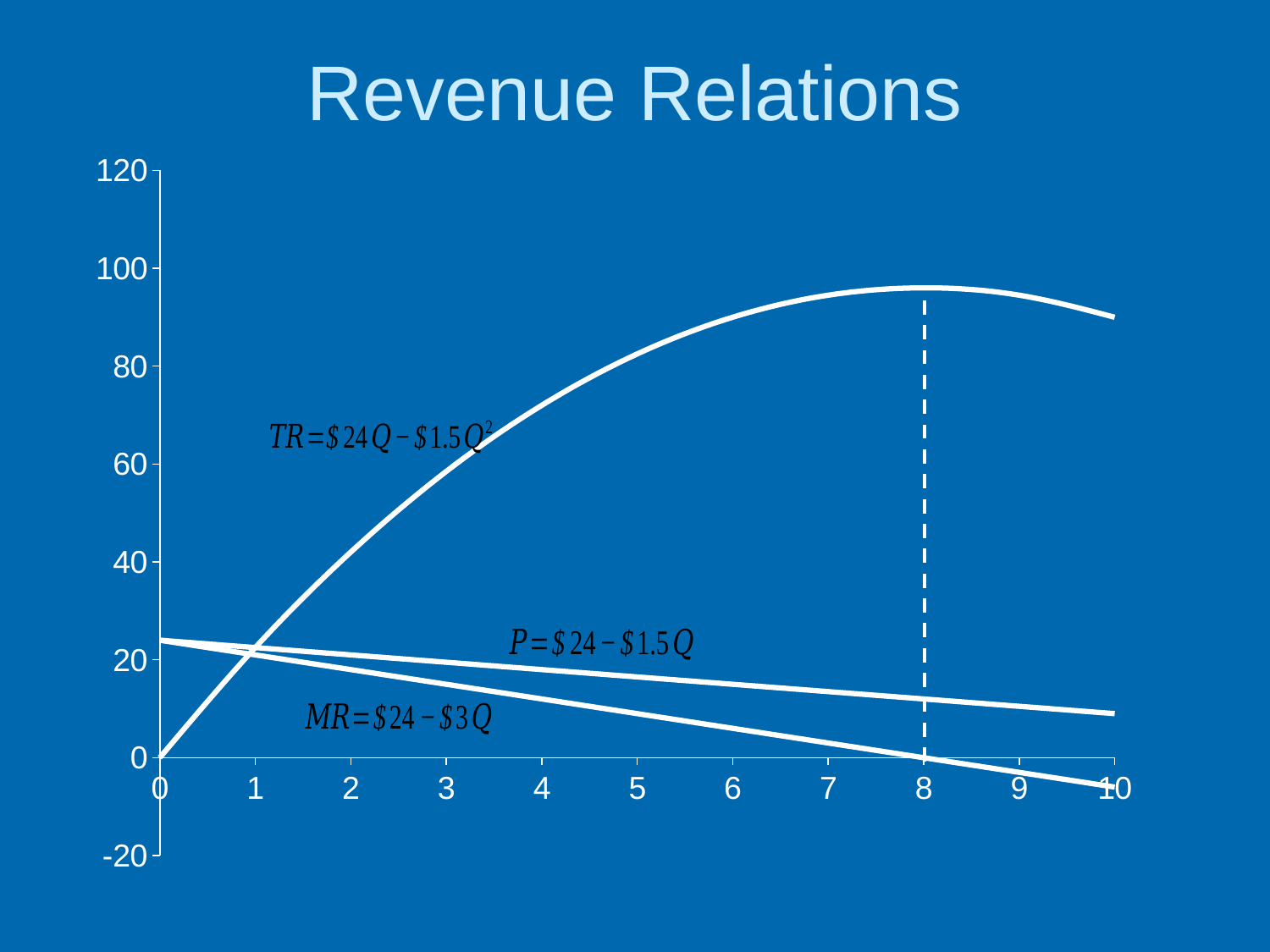
Is the value of TR at Q = 8 greater or less than 80? greater How many curves are plotted on the chart? 3 Does the TR curve rise or fall as Q increases from 0 to 8? rises Is the value of MR at Q = 10 greater or less than 0? less At Q = 6, which is larger, P or MR? P At what value of Q is the dashed vertical line drawn? 8 Which curve reaches the highest value on the chart? TR What kind of chart is shown on the slide? line chart What is the title of the chart? Revenue Relations At Q = 4, which is larger, TR or P? TR Is the value of P at Q = 10 greater or less than 20? less Does the MR line rise or fall as Q increases? falls